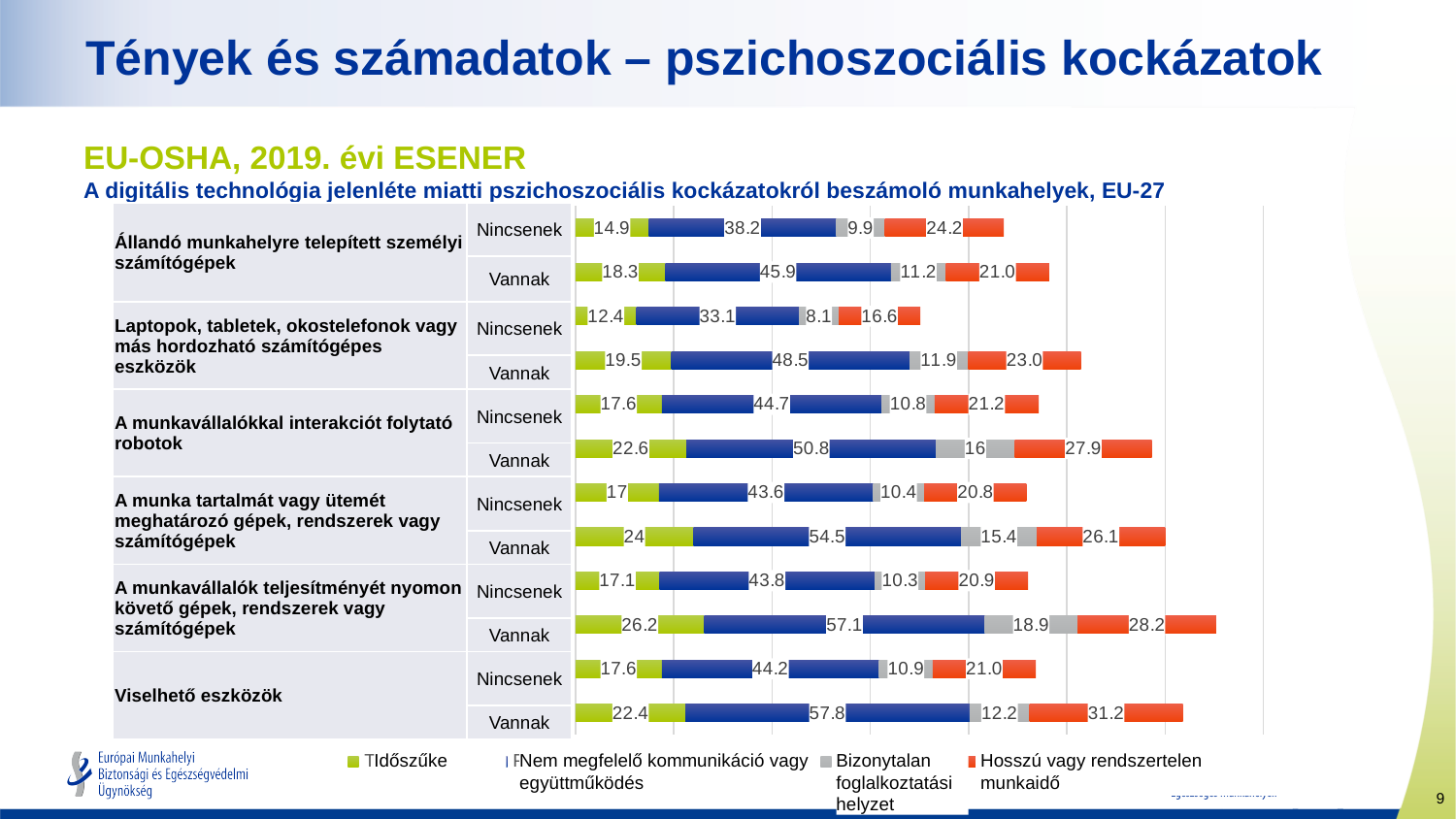
What is the value for Hosszú vagy rendszertelen munkaidő for 'Laptopok, tabletek, okostelefonok vagy más hordozható számítógépes eszközök – Nincsenek'? 16.6 Which bar has the highest value for Nem megfelelő kommunikáció vagy együttműködés? Viselhető eszközök – Vannak What is the total of the stacked bar for 'Laptopok, tabletek, okostelefonok vagy más hordozható számítógépes eszközök – Nincsenek'? 70.2 What is the value for Nem megfelelő kommunikáció vagy együttműködés for 'A munkavállalókkal interakciót folytató robotok – Vannak'? 50.8 Which is larger: Hosszú vagy rendszertelen munkaidő for 'Állandó munkahelyre telepített személyi számítógépek – Nincsenek' or for 'Állandó munkahelyre telepített személyi számítógépek – Vannak'? Nincsenek What is the value for Bizonytalan foglalkoztatási helyzet for 'A munkavállalók teljesítményét nyomon követő gépek, rendszerek vagy számítógépek – Vannak'? 18.9 What is the value for Időszűke for 'Viselhető eszközök – Vannak'? 22.4 How many series does the legend list? 4 What is the difference in Időszűke between 'Vannak' and 'Nincsenek' for 'A munka tartalmát vagy ütemét meghatározó gépek, rendszerek vagy számítógépek'? 7 Which bar has the lowest value for Időszűke? Laptopok, tabletek, okostelefonok vagy más hordozható számítógépes eszközök – Nincsenek How many bars are plotted in the chart? 12 What kind of chart is shown on the slide? Stacked bar chart